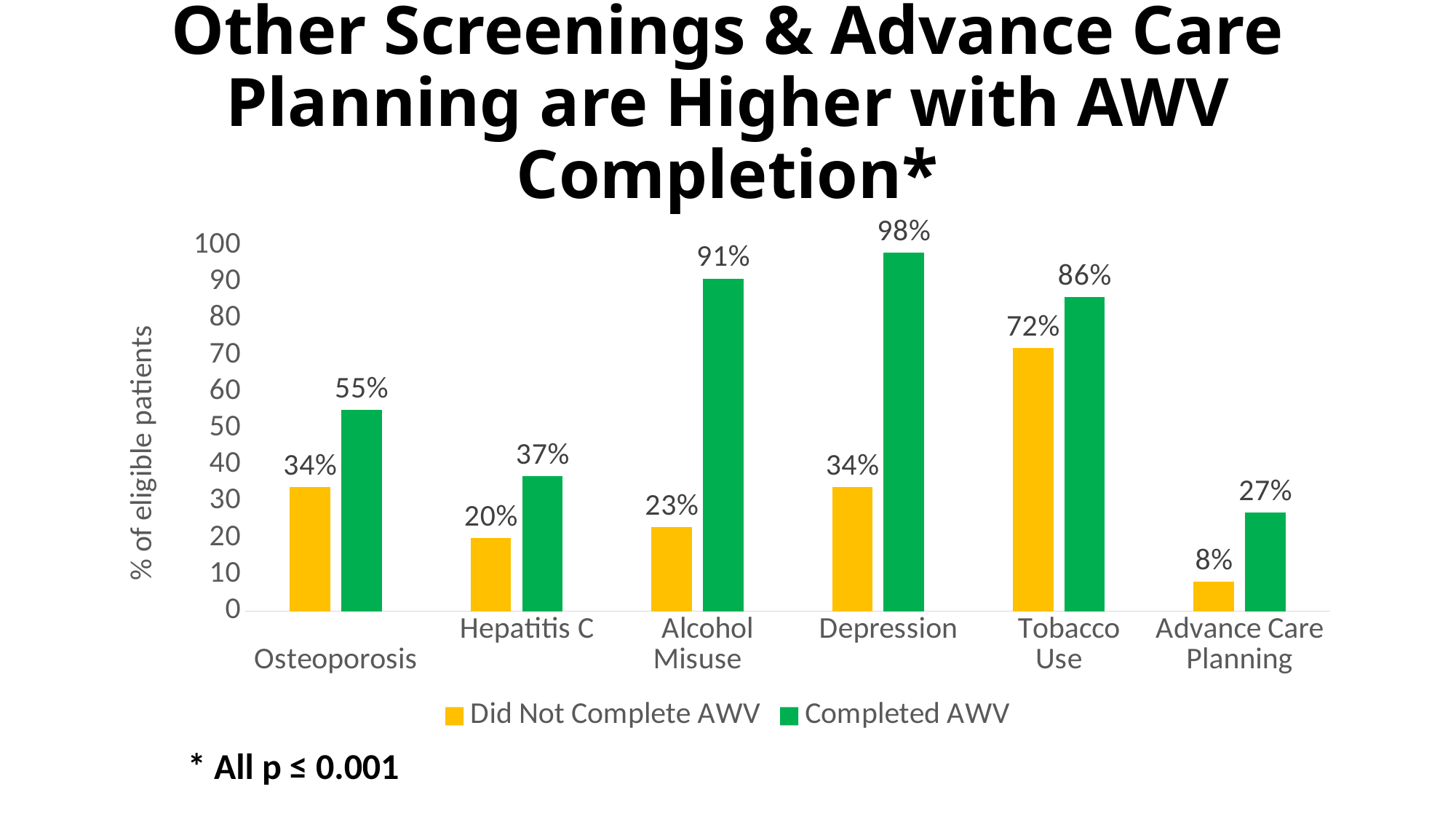
Which category has the highest value for Completed AWV? Depression What is the value for Completed AWV in the Depression category? 98% What is the label of the y axis? % of eligible patients How many categories are shown on the x axis? 6 What is the value for Did Not Complete AWV in the Tobacco Use category? 72% What is the difference between Completed AWV and Did Not Complete AWV for Alcohol Misuse? 68% What kind of chart is shown on the slide? Bar chart Which category has the lowest value for Did Not Complete AWV? Advance Care Planning Which colour represents the Completed AWV series? Green How many series does the legend list? 2 What is the value for Did Not Complete AWV in the Advance Care Planning category? 8% Which is larger: the Completed AWV value for Osteoporosis or the Completed AWV value for Hepatitis C? Osteoporosis